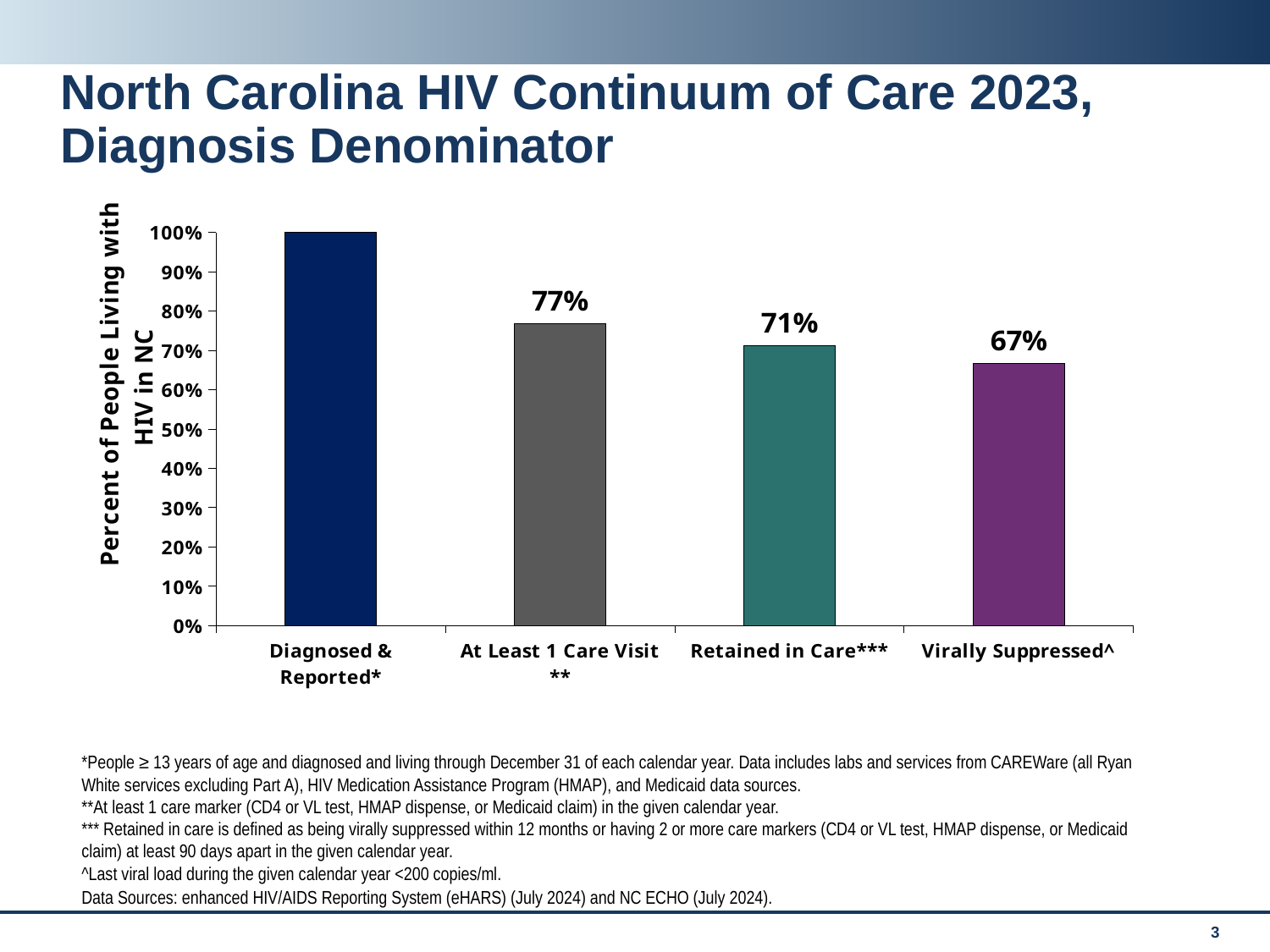
What is the value for Retained in Care? 71% What is the difference between At Least 1 Care Visit and Retained in Care? 6% How many categories are shown on the x axis? 4 Which category has the highest value? Diagnosed & Reported What is the value for Virally Suppressed? 67% Which is larger, Retained in Care or Virally Suppressed? Retained in Care Which category has the lowest value? Virally Suppressed Do the values rise or fall from left to right along the x axis? Fall What is the value for At Least 1 Care Visit? 77% What kind of chart is shown? Bar chart What is the value for Diagnosed & Reported? 100% What is the difference between At Least 1 Care Visit and Virally Suppressed? 10%